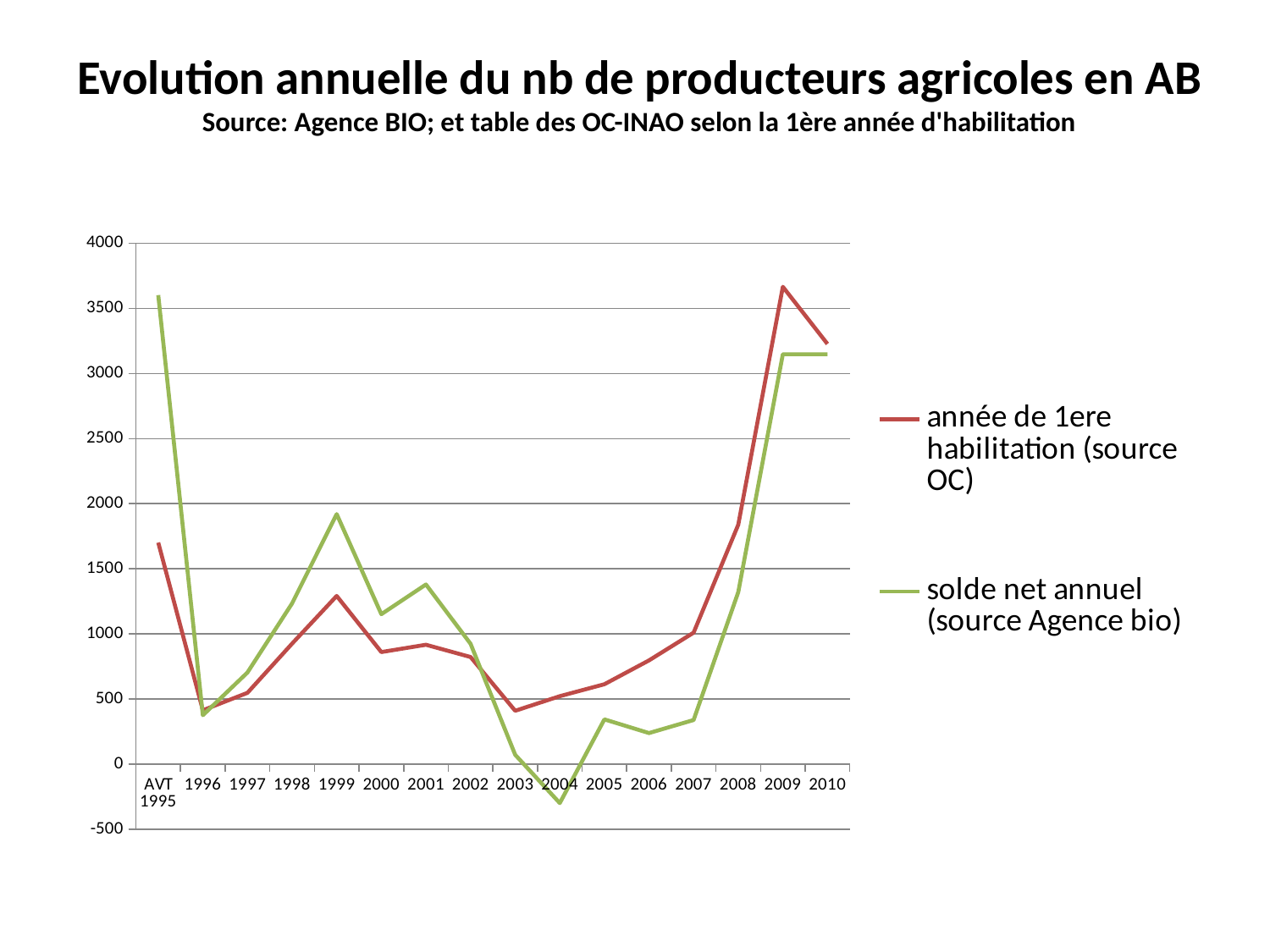
Is the value for 'solde net annuel (source Agence bio)' in 1999 greater or less than 1500? greater How many categories are shown along the x axis? 16 Is the value for 'année de 1ere habilitation (source OC)' in 2009 greater or less than 3500? greater What colour is the line for 'solde net annuel (source Agence bio)'? green In which category does the 'solde net annuel (source Agence bio)' series reach its highest value? AVT 1995 What kind of chart is shown on the slide? line chart Is the value for 'solde net annuel (source Agence bio)' in 2004 greater or less than 0? less In which year does the 'année de 1ere habilitation (source OC)' series reach its highest value? 2009 Does the 'année de 1ere habilitation (source OC)' series rise or fall from 2007 to 2009? rise In which year does the 'solde net annuel (source Agence bio)' series reach its lowest value? 2004 How many series does the legend list? 2 In 2009, which series has the higher value: 'année de 1ere habilitation (source OC)' or 'solde net annuel (source Agence bio)'? année de 1ere habilitation (source OC)